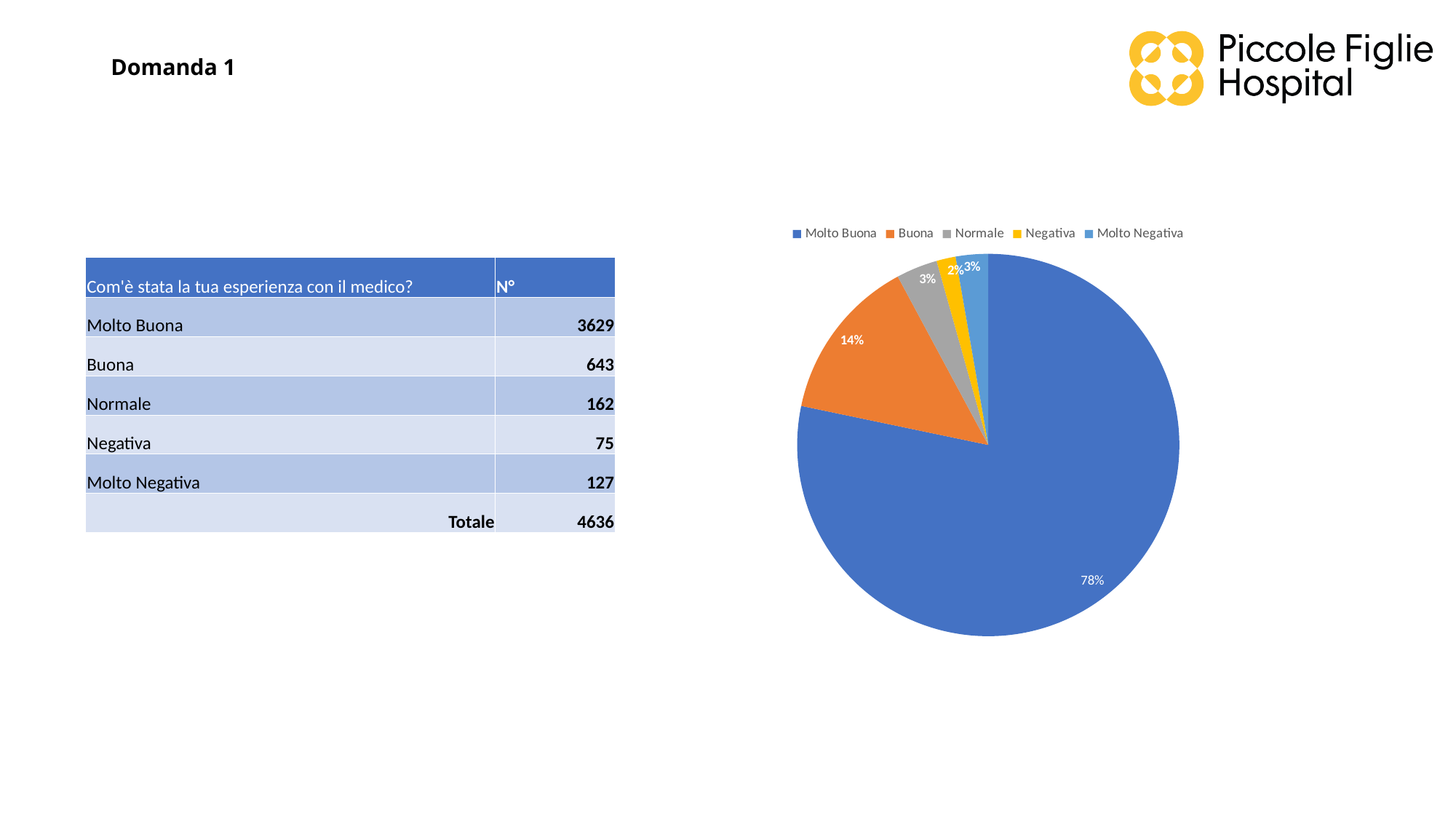
What share of the pie chart does the Buona slice represent? 14% What colour is the Buona slice in the pie chart? orange What share of the pie chart does the Molto Buona slice represent? 78% What share of the pie chart does the Normale slice represent? 3% In the pie chart, which slice is larger: Buona or Normale? Buona How many entries does the pie chart's legend list? 5 Which category has the largest slice in the pie chart? Molto Buona What kind of chart is shown on the slide? pie chart What is the difference in percentage points between the Molto Buona and Buona slices in the pie chart? 64 Which category has the smallest slice in the pie chart? Negativa How many slices does the pie chart have? 5